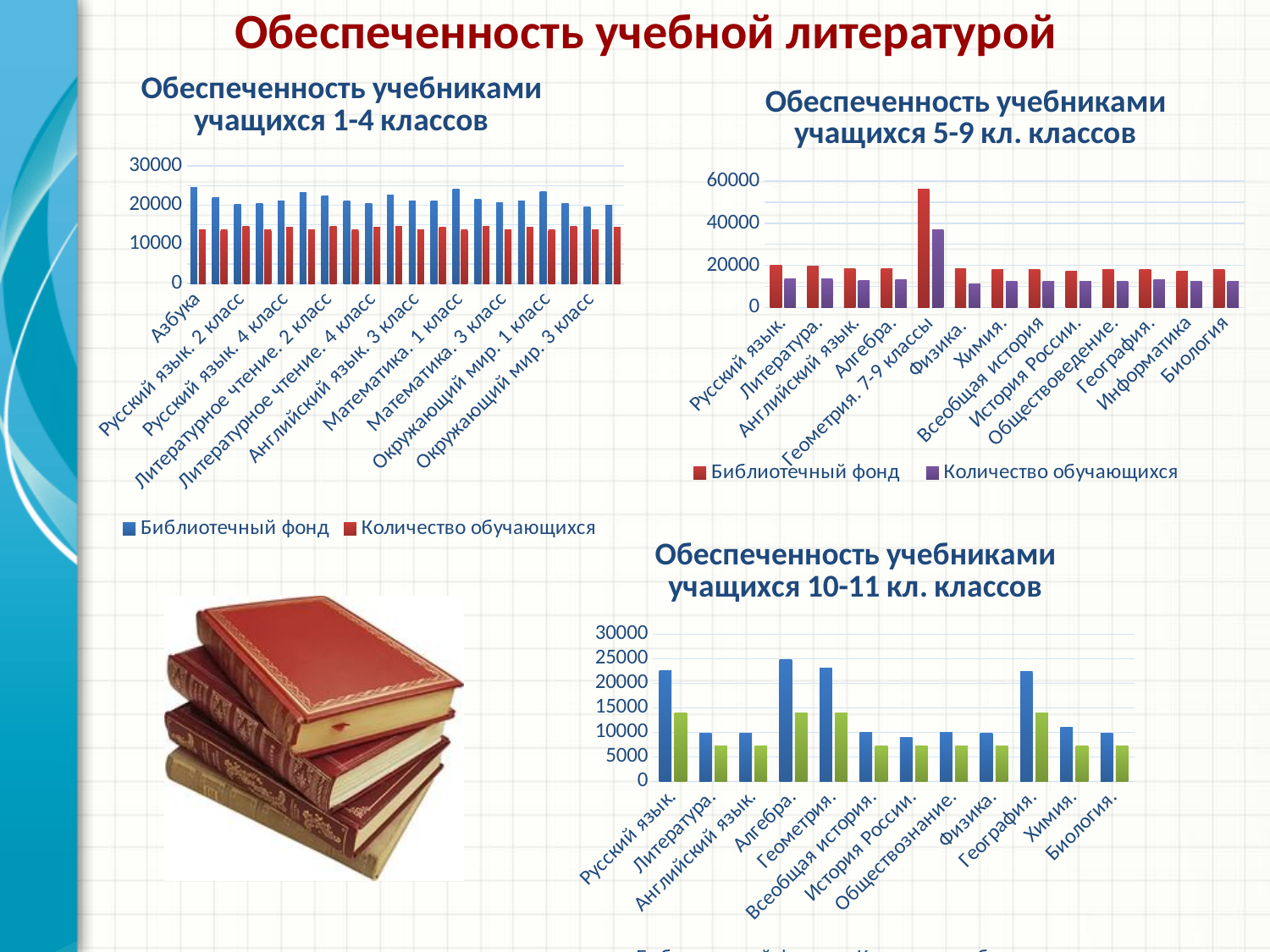
In the 'Обеспеченность учебниками учащихся 5-9 кл. классов' chart, which is larger: the Библиотечный фонд value for Геометрия. 7-9 классы or for Физика? Геометрия. 7-9 классы How many categories are shown on the x axis of the 'Обеспеченность учебниками учащихся 5-9 кл. классов' chart? 13 In the 'Обеспеченность учебниками учащихся 5-9 кл. классов' chart, is the Библиотечный фонд value for Геометрия. 7-9 классы greater or less than 40000? greater In the 'Обеспеченность учебниками учащихся 5-9 кл. классов' chart, is the Количество обучающихся value for Химия greater or less than 20000? less In the 'Обеспеченность учебниками учащихся 5-9 кл. классов' chart, which category has the highest Библиотечный фонд value? Геометрия. 7-9 классы In the 'Обеспеченность учебниками учащихся 10-11 кл. классов' chart, which category has the tallest blue bar? Алгебра In the 'Обеспеченность учебниками учащихся 1-4 классов' chart, is the Библиотечный фонд value for Азбука greater or less than 20000? greater How many categories are shown on the x axis of the 'Обеспеченность учебниками учащихся 10-11 кл. классов' chart? 12 How many series does the legend of the 'Обеспеченность учебниками учащихся 1-4 классов' chart list? 2 What are the two legend entries of the 'Обеспеченность учебниками учащихся 1-4 классов' chart? Библиотечный фонд, Количество обучающихся What type of chart is the 'Обеспеченность учебниками учащихся 1-4 классов' chart? bar chart